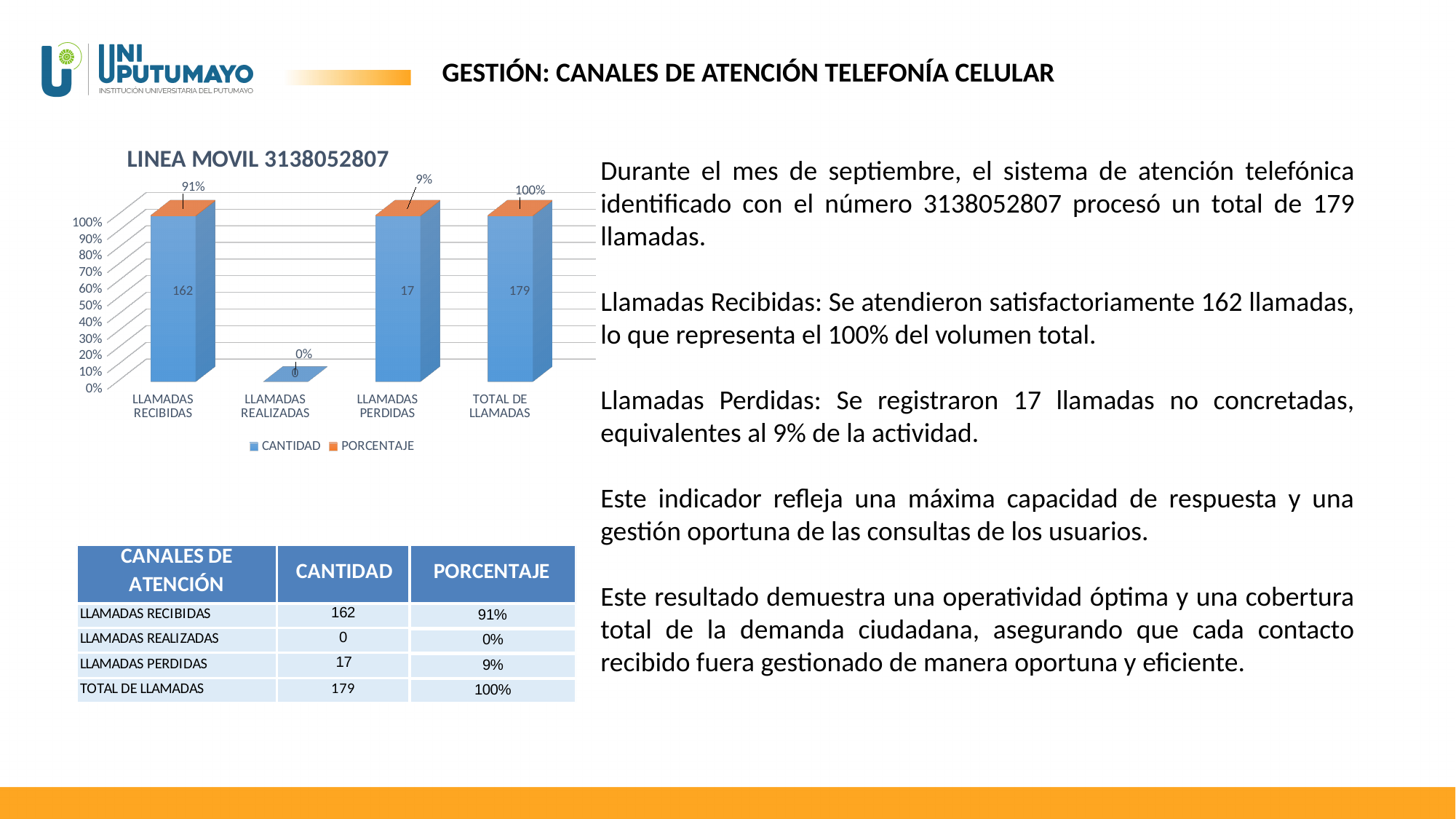
How many categories are shown on the x axis of the chart? 4 What is the PORCENTAJE value for LLAMADAS PERDIDAS? 9% What is the PORCENTAJE value for LLAMADAS RECIBIDAS? 91% Which is larger, the CANTIDAD value for LLAMADAS RECIBIDAS or for LLAMADAS PERDIDAS? LLAMADAS RECIBIDAS What is the CANTIDAD value for LLAMADAS PERDIDAS? 17 What is the CANTIDAD value for TOTAL DE LLAMADAS? 179 How many series does the chart legend list? 2 What is the title of the chart? LINEA MOVIL 3138052807 What is the CANTIDAD value for LLAMADAS RECIBIDAS? 162 What type of chart is shown on the slide? bar chart Which category has the lowest CANTIDAD value? LLAMADAS REALIZADAS What is the difference between the CANTIDAD values for LLAMADAS RECIBIDAS and LLAMADAS PERDIDAS? 145